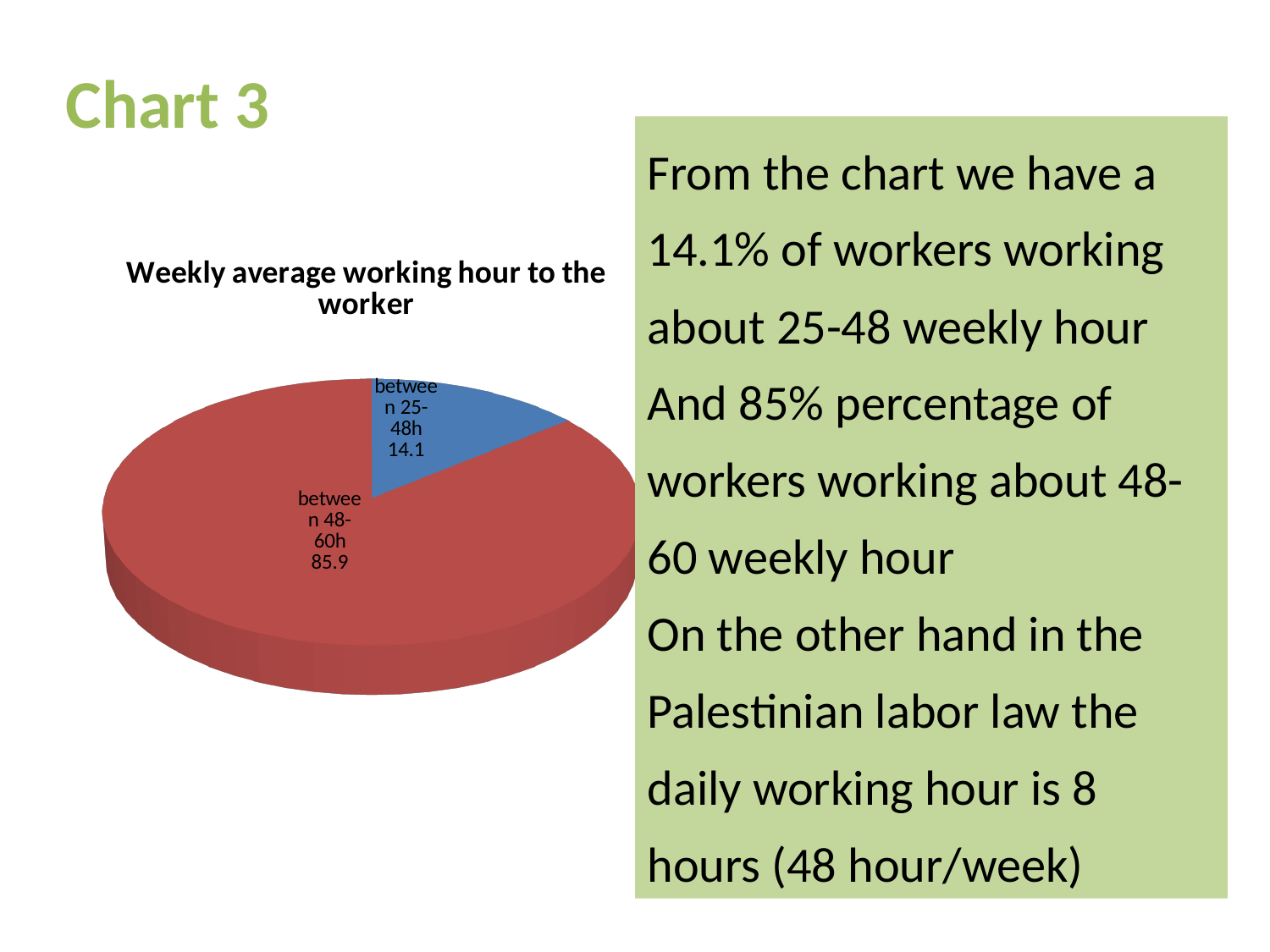
What is the value for the 'between 25-48h' slice in the pie chart? 14.1 What kind of chart is shown on the slide? pie chart What is the difference between the 'between 48-60h' and 'between 25-48h' values? 71.8 Which category has the smallest slice in the pie chart? between 25-48h Which category has the largest slice in the pie chart? between 48-60h Which is larger, the 'between 25-48h' slice or the 'between 48-60h' slice? between 48-60h What is the title of the chart? Weekly average working hour to the worker What is the total of the two slice values in the pie chart? 100 How many slices does the pie chart have? 2 What colour is the 'between 48-60h' slice? red What is the value for the 'between 48-60h' slice in the pie chart? 85.9